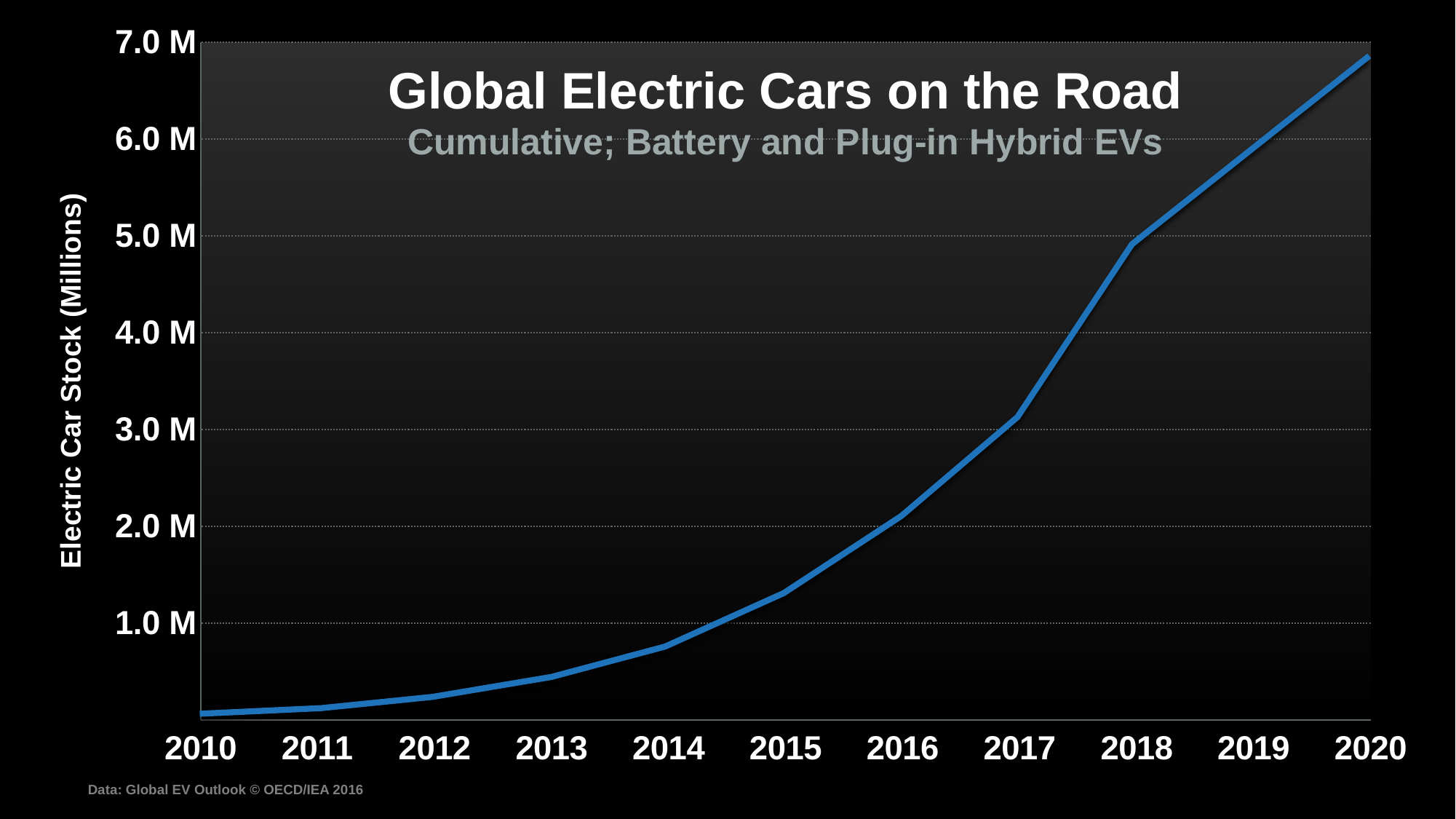
How many years are shown along the x axis? 11 Do the values rise or fall from 2010 to 2020? rise Is the value for 2014 greater or less than 1.0 M? less Which year has the lowest electric car stock? 2010 Which is larger, the value for 2017 or the value for 2015? 2017 Is the value for 2016 greater or less than 2.0 M? greater What is the title of the chart? Global Electric Cars on the Road Which year has the highest electric car stock? 2020 Is the value for 2018 greater or less than 5.0 M? less What kind of chart is shown on the slide? line chart What is the label on the vertical axis? Electric Car Stock (Millions)